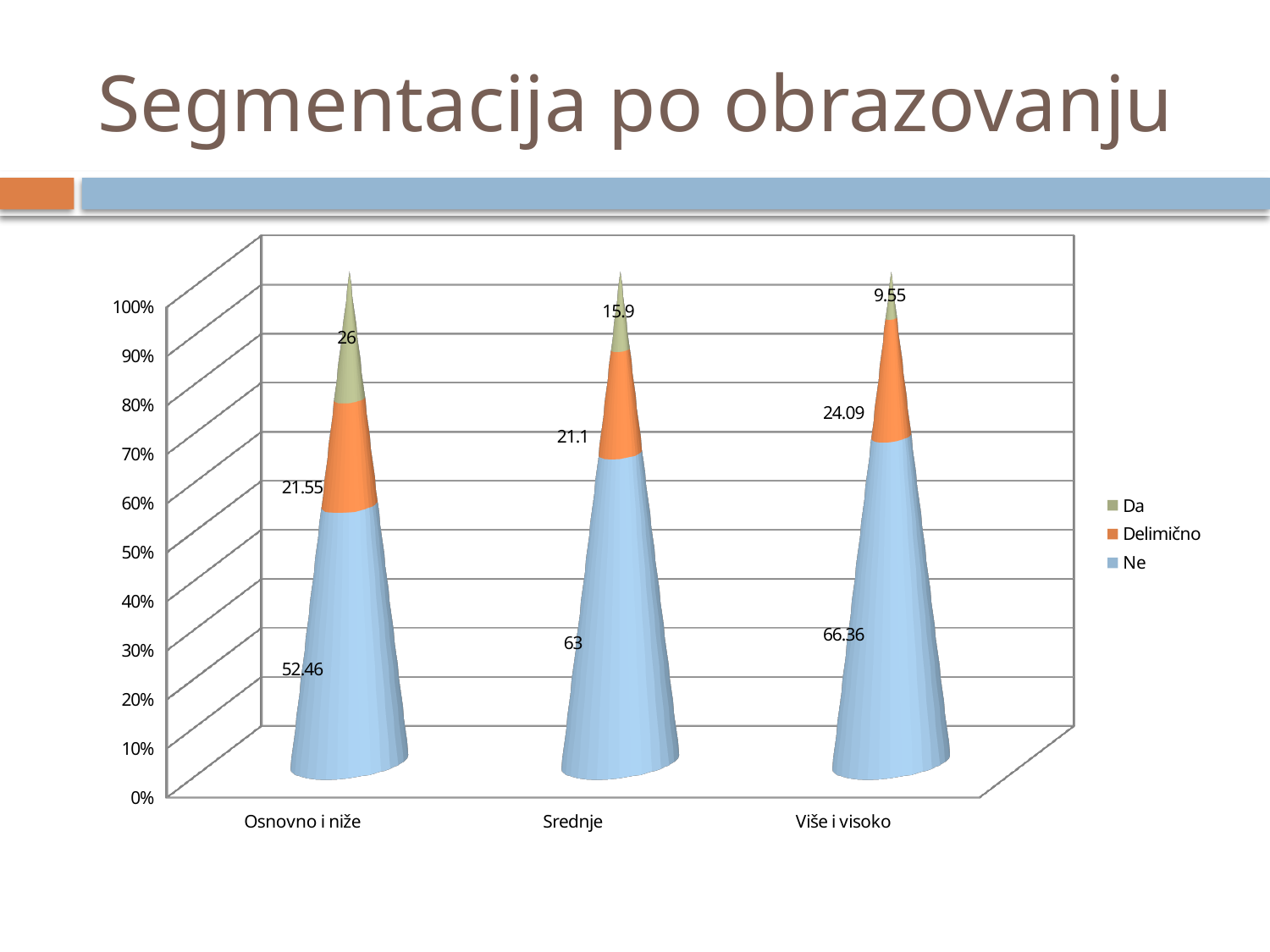
What is the difference between the "Ne" values for "Više i visoko" and "Osnovno i niže"? 13.9 What is the value of the "Da" series for "Više i visoko"? 9.55 How many series does the legend list? 3 How many categories are shown on the x axis? 3 What kind of chart is shown on the slide? Stacked bar chart What is the value of the "Ne" series for "Srednje"? 63 What is the value of the "Delimično" series for "Osnovno i niže"? 21.55 What is the value of the "Ne" series for "Više i visoko"? 66.36 Does the "Da" series rise or fall from "Osnovno i niže" to "Više i visoko"? Fall Which category has the highest value for the "Da" series? Osnovno i niže Which is larger: the "Delimično" value for "Više i visoko" or for "Srednje"? Više i visoko Which category has the lowest value for the "Ne" series? Osnovno i niže